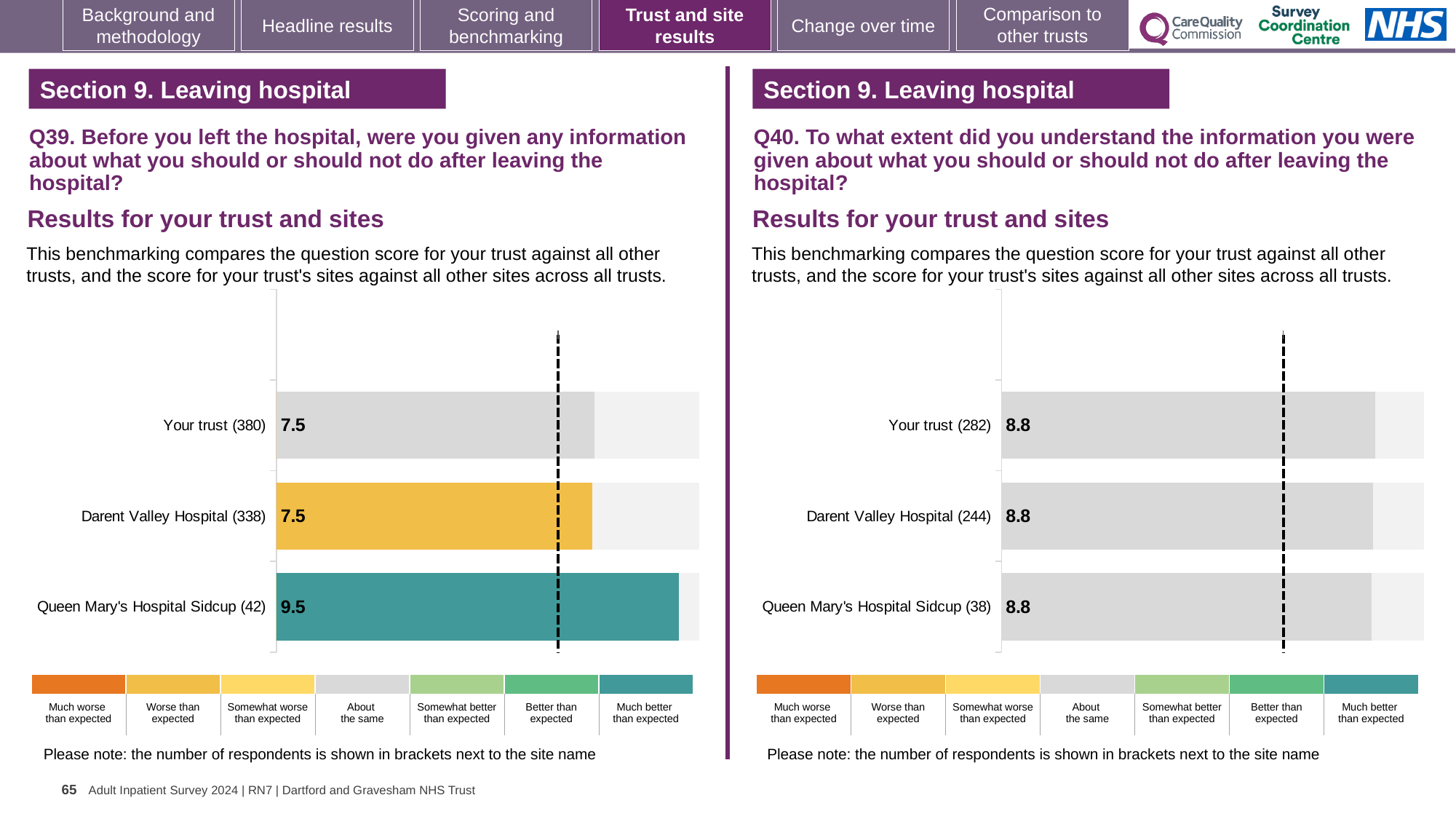
In the Q39 chart on the left, what is the score for Your trust? 7.5 In the Q39 chart on the left, which site has the highest score? Queen Mary's Hospital Sidcup In the Q39 chart on the left, what is the score for Queen Mary's Hospital Sidcup? 9.5 In the Q39 chart on the left, what is the difference between the scores for Queen Mary's Hospital Sidcup and Darent Valley Hospital? 2.0 In the Q39 chart on the left, which benchmark category does the colour of the Darent Valley Hospital bar correspond to in the legend? Worse than expected In the Q39 chart on the left, how many respondents are shown in brackets for Queen Mary's Hospital Sidcup? 42 In the Q40 chart on the right, what is the score for Your trust? 8.8 In the Q40 chart on the right, what is the score for Queen Mary's Hospital Sidcup? 8.8 In the Q39 chart on the left, which has the larger score, Darent Valley Hospital or Queen Mary's Hospital Sidcup? Queen Mary's Hospital Sidcup How many bars are shown in the Q40 chart on the right? 3 In the Q39 chart on the left, what is the score for Darent Valley Hospital? 7.5 What type of chart is used in the Q39 chart on the left? Bar chart